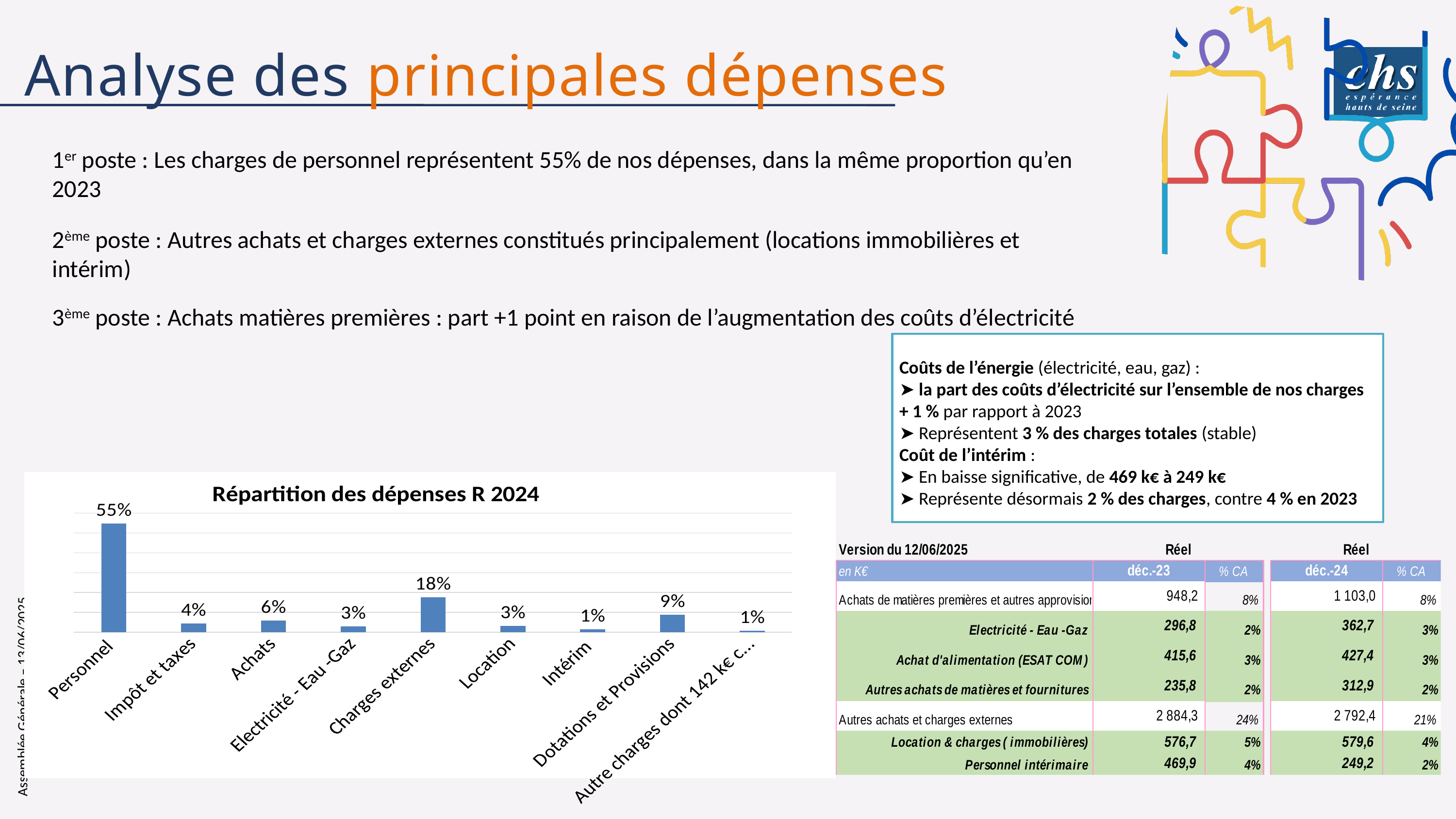
What is the difference between the values for Dotations et Provisions and Impôt et taxes? 5% What kind of chart is shown on the slide? Bar chart What is the value for Achats in the chart? 6% What is the value for Charges externes in the chart? 18% What is the difference between the values for Personnel and Charges externes? 37% What is the title of the chart on the slide? Répartition des dépenses R 2024 What is the value for Dotations et Provisions in the chart? 9% How many categories are shown in the chart? 9 Which category has the highest value in the chart? Personnel Which is larger, the value for Impôt et taxes or the value for Intérim? Impôt et taxes Which is larger, the value for Achats or the value for Location? Achats What is the value for Personnel in the chart "Répartition des dépenses R 2024"? 55%